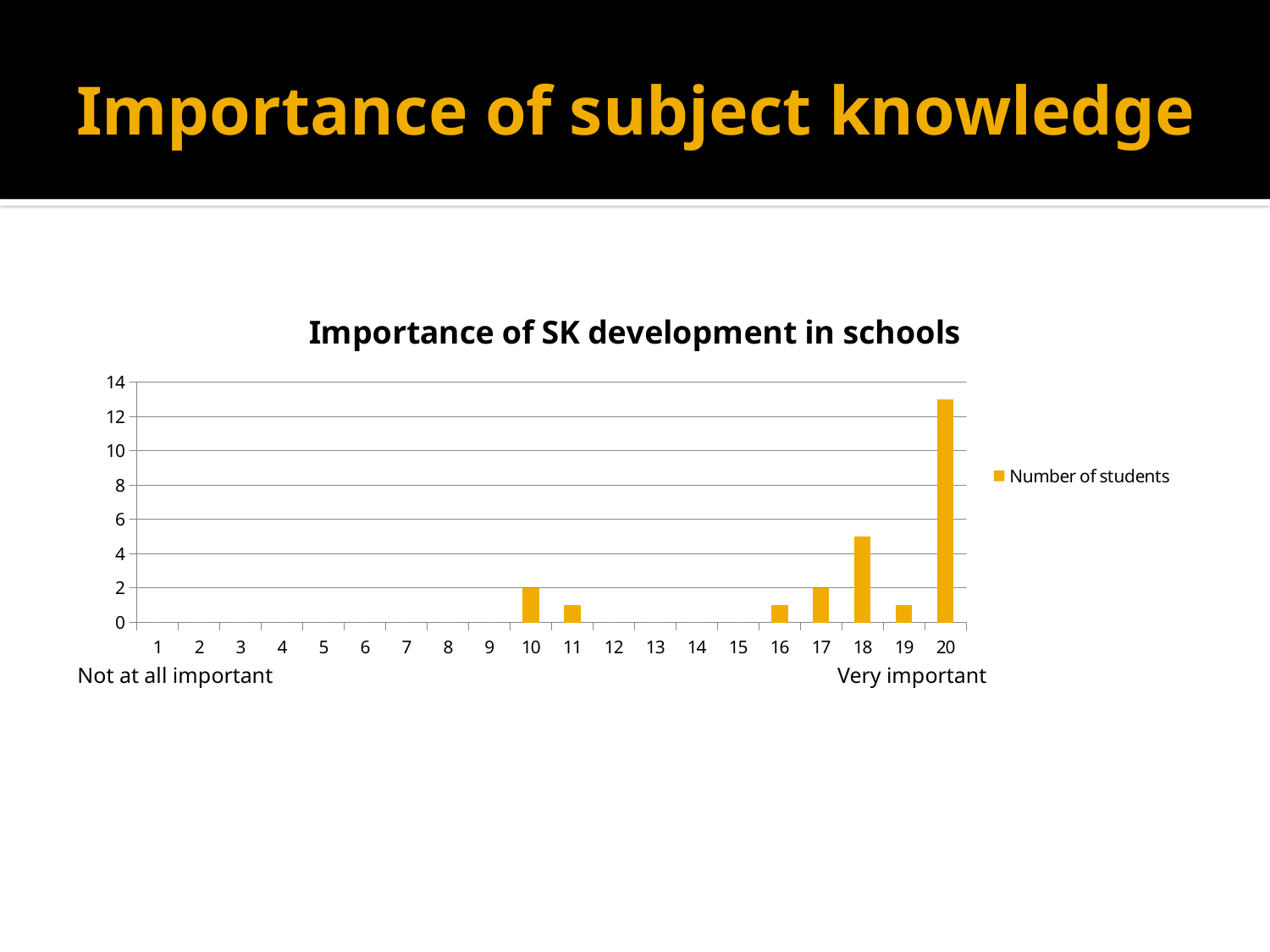
Is the value for category 20 greater or less than 12? greater What is the name of the series shown in the legend? Number of students What is the number of students for category 10? 2 Which category has the highest number of students? 20 Is the value for category 18 greater or less than 4? greater What is the number of students for category 17? 2 Is the value for category 11 greater or less than 2? less How many series does the legend list? 1 What is the title of the chart? Importance of SK development in schools What kind of chart is shown on the slide? bar chart How many categories are shown on the x axis? 20 Which has a larger number of students, category 18 or category 20? 20